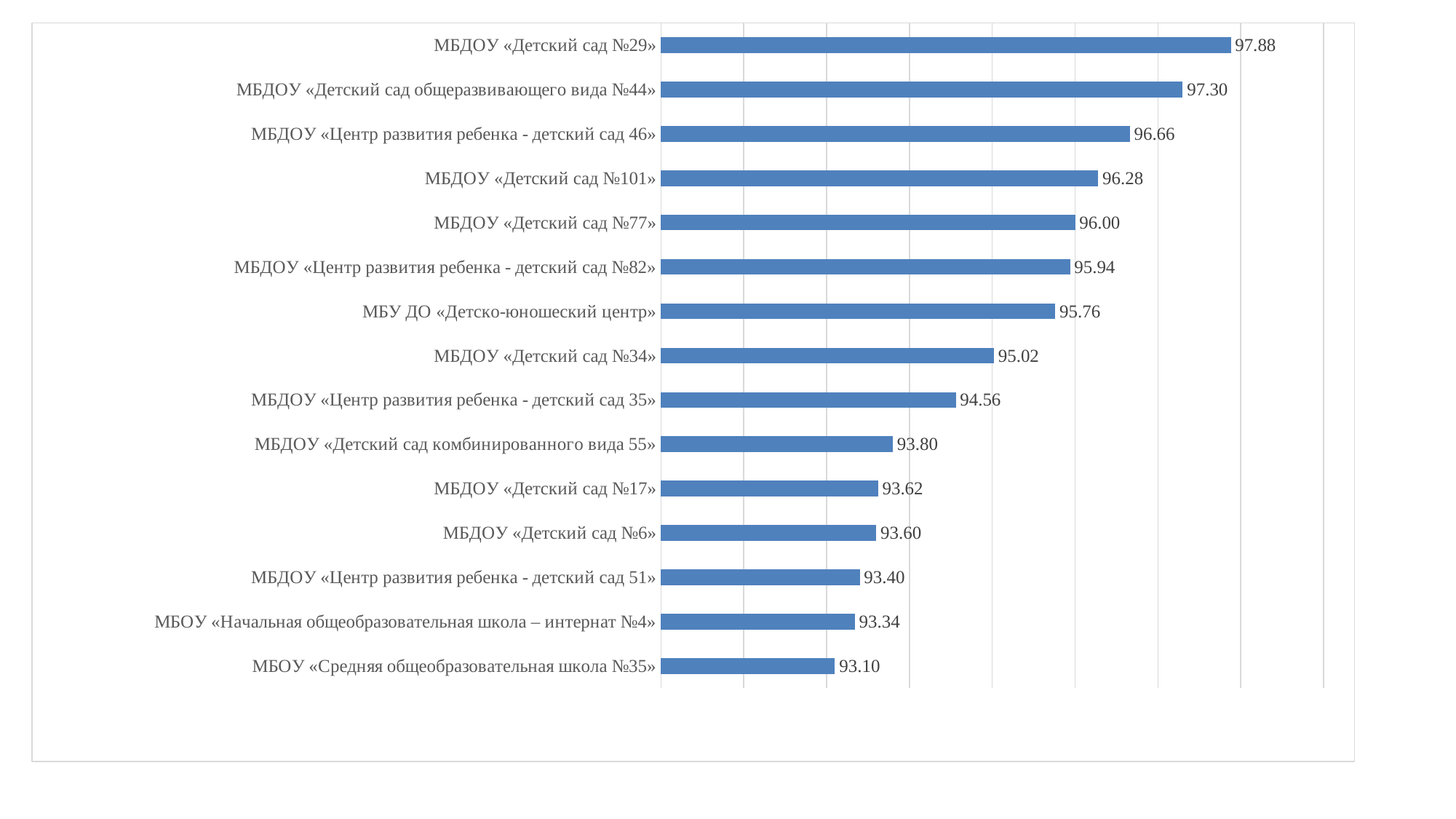
What is the value for МБДОУ «Детский сад комбинированного вида 55»? 93.80 Which has a larger value: МБДОУ «Центр развития ребенка - детский сад 46» or МБДОУ «Центр развития ребенка - детский сад 35»? МБДОУ «Центр развития ребенка - детский сад 46» What is the difference between the values for МБДОУ «Детский сад №29» and МБОУ «Средняя общеобразовательная школа №35»? 4.78 What is the value for МБДОУ «Детский сад №29»? 97.88 What is the difference between the values for МБДОУ «Детский сад №101» and МБДОУ «Детский сад №34»? 1.26 Which category has the highest value? МБДОУ «Детский сад №29» Which category has the lowest value? МБОУ «Средняя общеобразовательная школа №35» What kind of chart is shown on the slide? bar chart What is the value for МБУ ДО «Детско-юношеский центр»? 95.76 Do the values increase or decrease going from the top bar to the bottom bar? decrease What is the value for МБОУ «Начальная общеобразовательная школа – интернат №4»? 93.34 How many categories (organisations) are plotted in the chart? 15